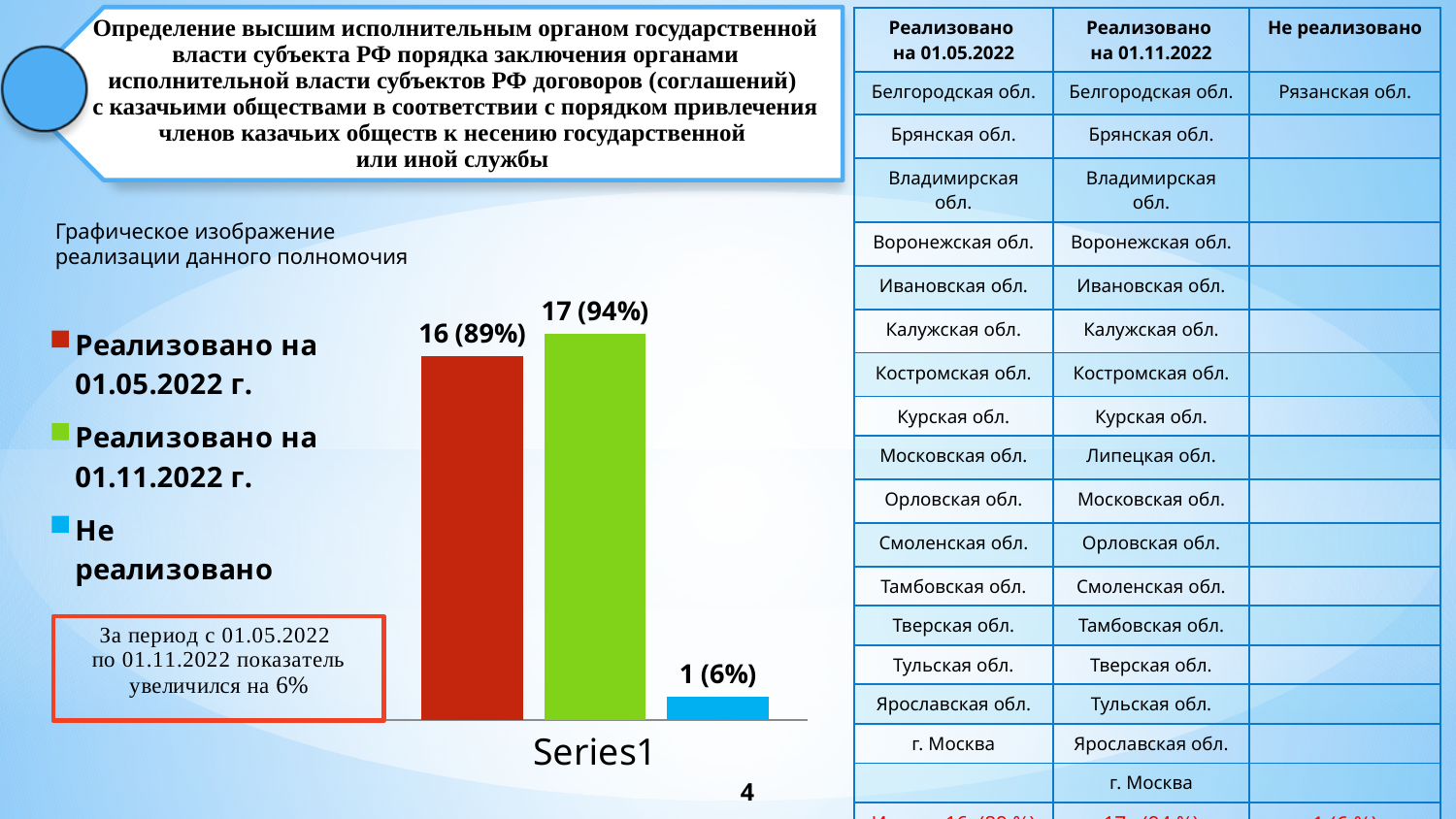
What is the difference in percentage points between "Реализовано на 01.11.2022 г." and "Реализовано на 01.05.2022 г."? 5% What is the value shown for the series "Реализовано на 01.11.2022 г."? 17 (94%) What is the difference in count between "Реализовано на 01.11.2022 г." and "Реализовано на 01.05.2022 г."? 1 What colour is the bar for "Не реализовано"? Blue What is the value shown for the series "Реализовано на 01.05.2022 г."? 16 (89%) Which series has the lowest value in the chart? Не реализовано Which series has the highest value in the chart? Реализовано на 01.11.2022 г. What is the value shown for the series "Не реализовано"? 1 (6%) What is the category label shown under the bars on the x axis? Series1 How many series does the chart legend list? 3 Which is larger: the value for "Реализовано на 01.05.2022 г." or the value for "Не реализовано"? Реализовано на 01.05.2022 г. What kind of chart is shown on the slide? Bar chart